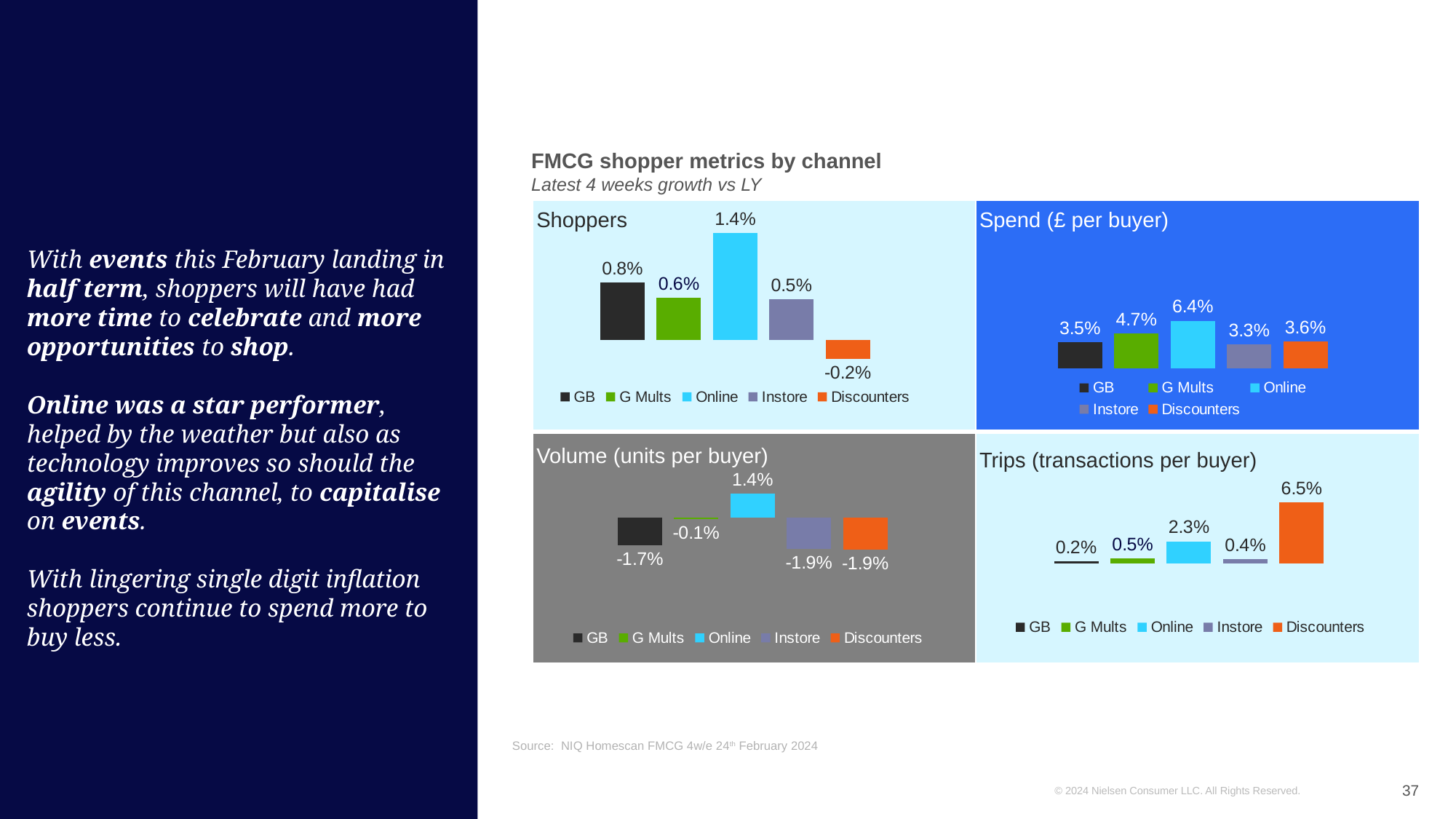
How many series does the legend of the Shoppers chart list? 5 What kind of chart is the Volume (units per buyer) chart? Bar chart In the Trips (transactions per buyer) chart, which is larger, Online or Instore? Online In the Volume (units per buyer) chart, which channel has the highest value? Online In the Shoppers chart, what is the value for Online? 1.4% In the Trips (transactions per buyer) chart, what is the value for Discounters? 6.5% In the Spend (£ per buyer) chart, what is the value for G Mults? 4.7% In the Spend (£ per buyer) chart, what is the difference between Online and Instore? 3.1% In the Spend (£ per buyer) chart, which channel has the highest value? Online In the Trips (transactions per buyer) chart, what is the difference between Discounters and GB? 6.3% In the Shoppers chart, which channel has the lowest value? Discounters In the Volume (units per buyer) chart, what is the value for GB? -1.7%